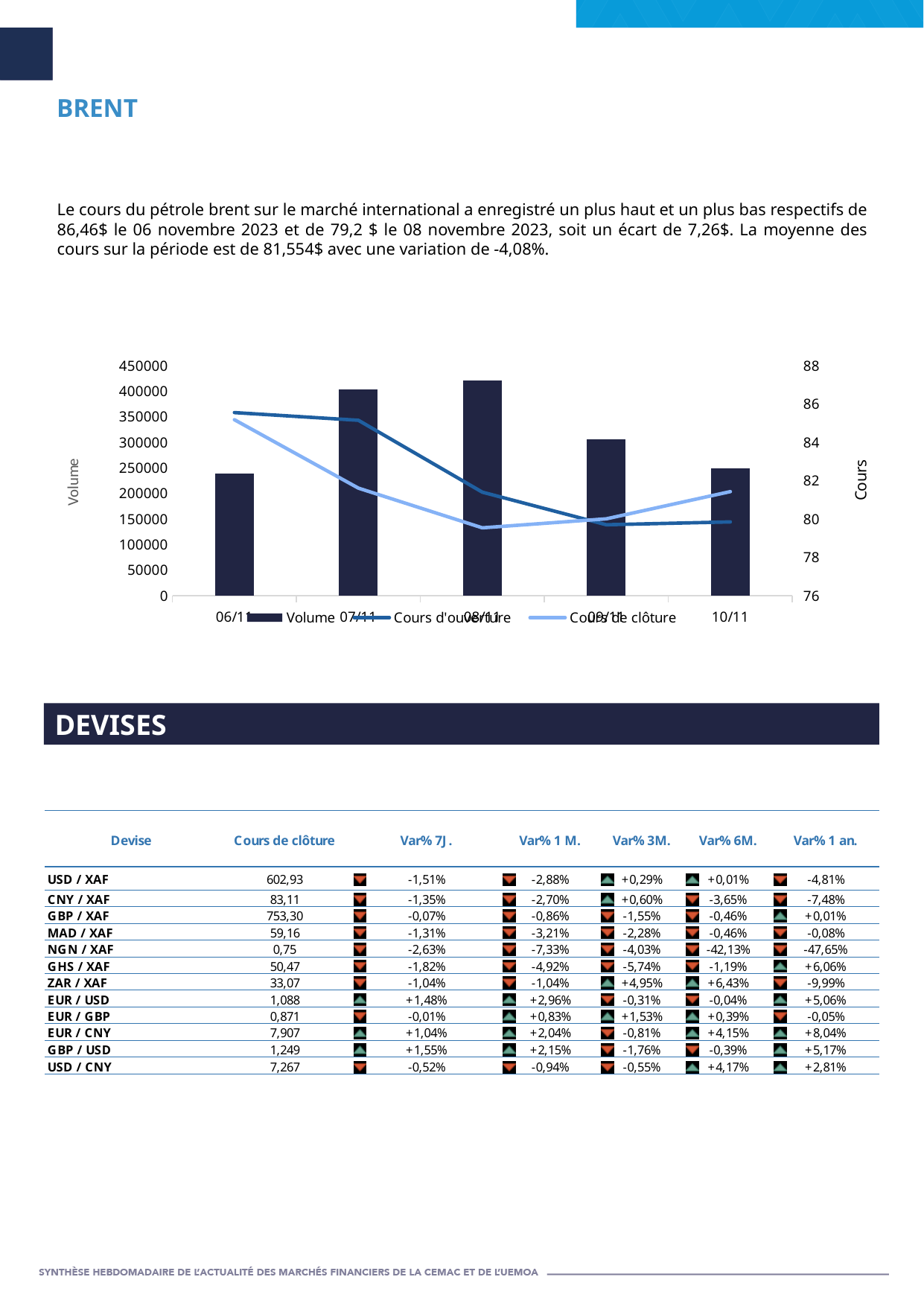
How many dates are shown on the x axis of the chart? 5 Does the Cours d'ouverture rise or fall from 06/11 to 09/11? fall Which has the larger Volume, 08/11 or 06/11? 08/11 Which series is plotted as bars in the chart? Volume Is the Volume for 07/11 greater or less than 350000? greater Is the Cours de clôture for 08/11 greater or less than 80? less Is the Volume for 09/11 greater or less than 250000? greater How many series does the chart legend list? 3 What kind of chart is shown under the BRENT heading? A combined bar and line chart What is the title of the right-hand vertical axis of the chart? Cours